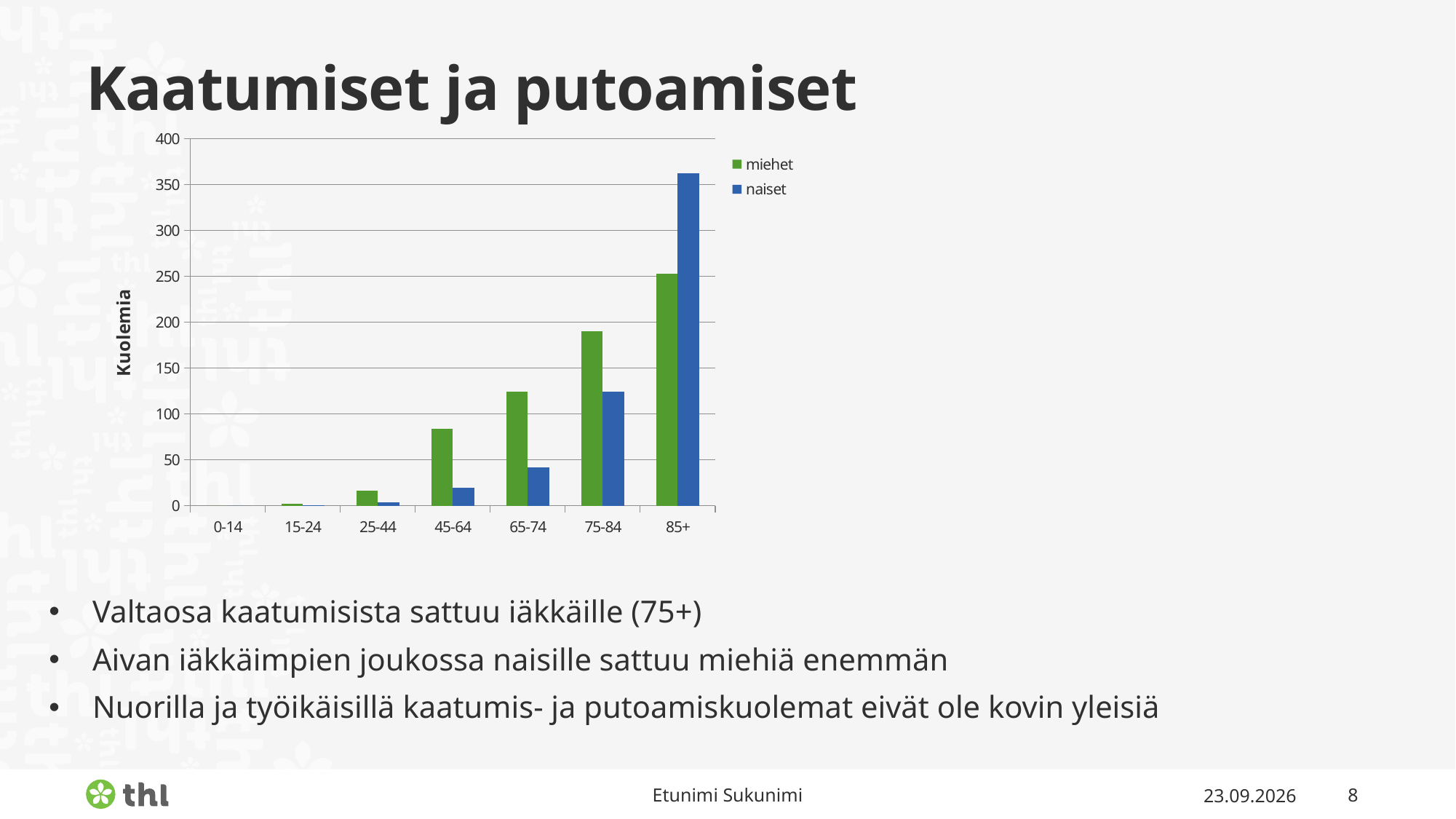
In the 85+ age group, which series has the larger value, miehet or naiset? naiset Is the value for miehet in the 85+ age group greater or less than 300? less Is the value for naiset in the 85+ age group greater or less than 350? greater Is the value for naiset in the 65-74 age group greater or less than 50? less In the 75-84 age group, which series has the larger value, miehet or naiset? miehet What is the title of the vertical axis? Kuolemia Which age group has the highest value for miehet? 85+ Which age group has the highest value for naiset? 85+ How many series does the legend list? 2 How many age groups are shown on the x axis? 7 What kind of chart is shown on the slide? bar chart